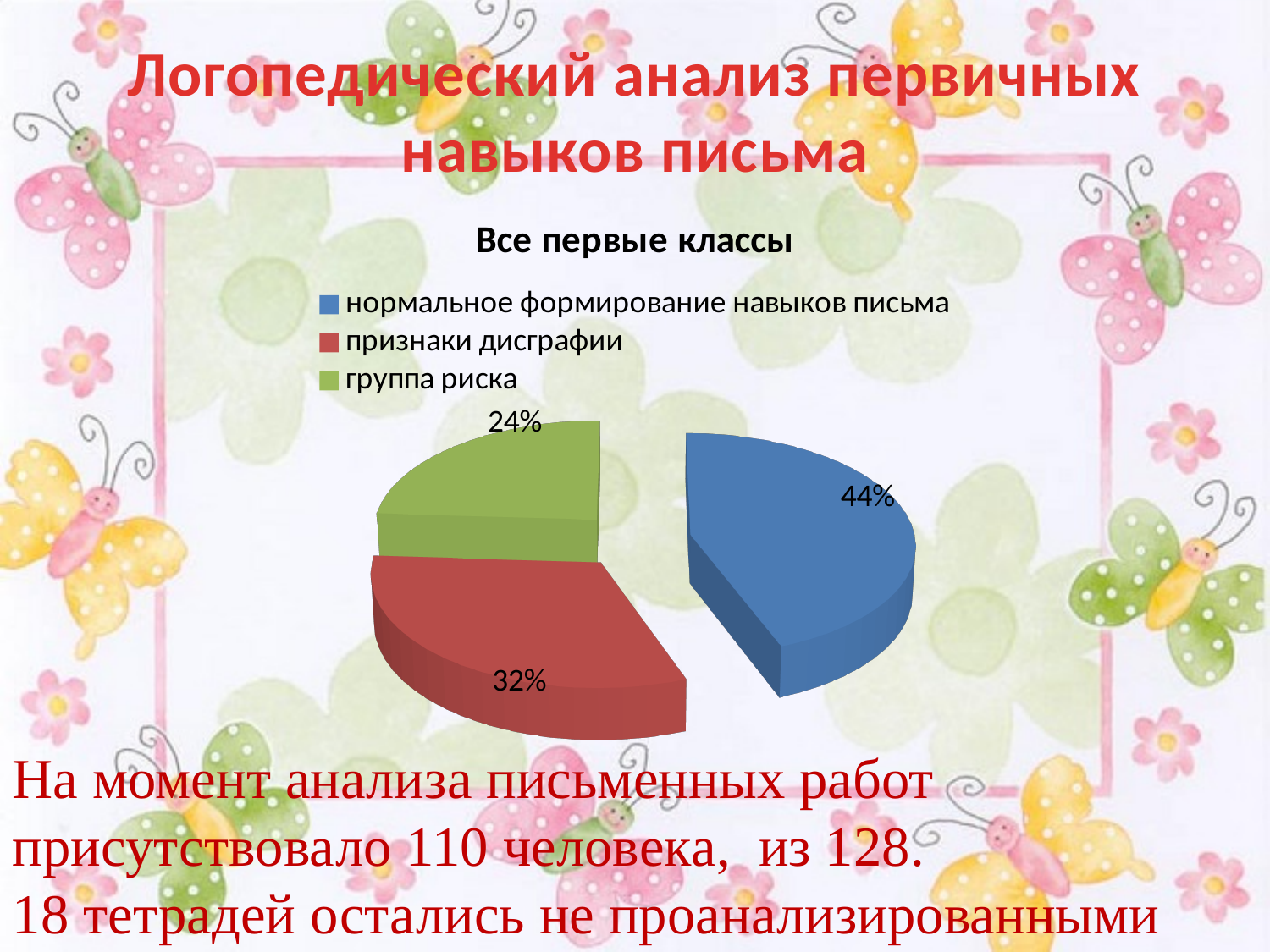
Which category has the smallest share of the pie? группа риска What is the title of the chart? Все первые классы What kind of chart is shown on the slide? pie chart Which is larger: the share for 'признаки дисграфии' or the share for 'группа риска'? признаки дисграфии Which category has the largest share of the pie? нормальное формирование навыков письма What share of the pie is labelled for 'нормальное формирование навыков письма'? 44% How many slices does the pie chart have? 3 What share of the pie is labelled for 'группа риска'? 24% How many entries does the legend list? 3 Which colour represents 'группа риска' in the pie chart? green What share of the pie is labelled for 'признаки дисграфии'? 32% What is the difference in percentage points between 'нормальное формирование навыков письма' and 'группа риска'? 20